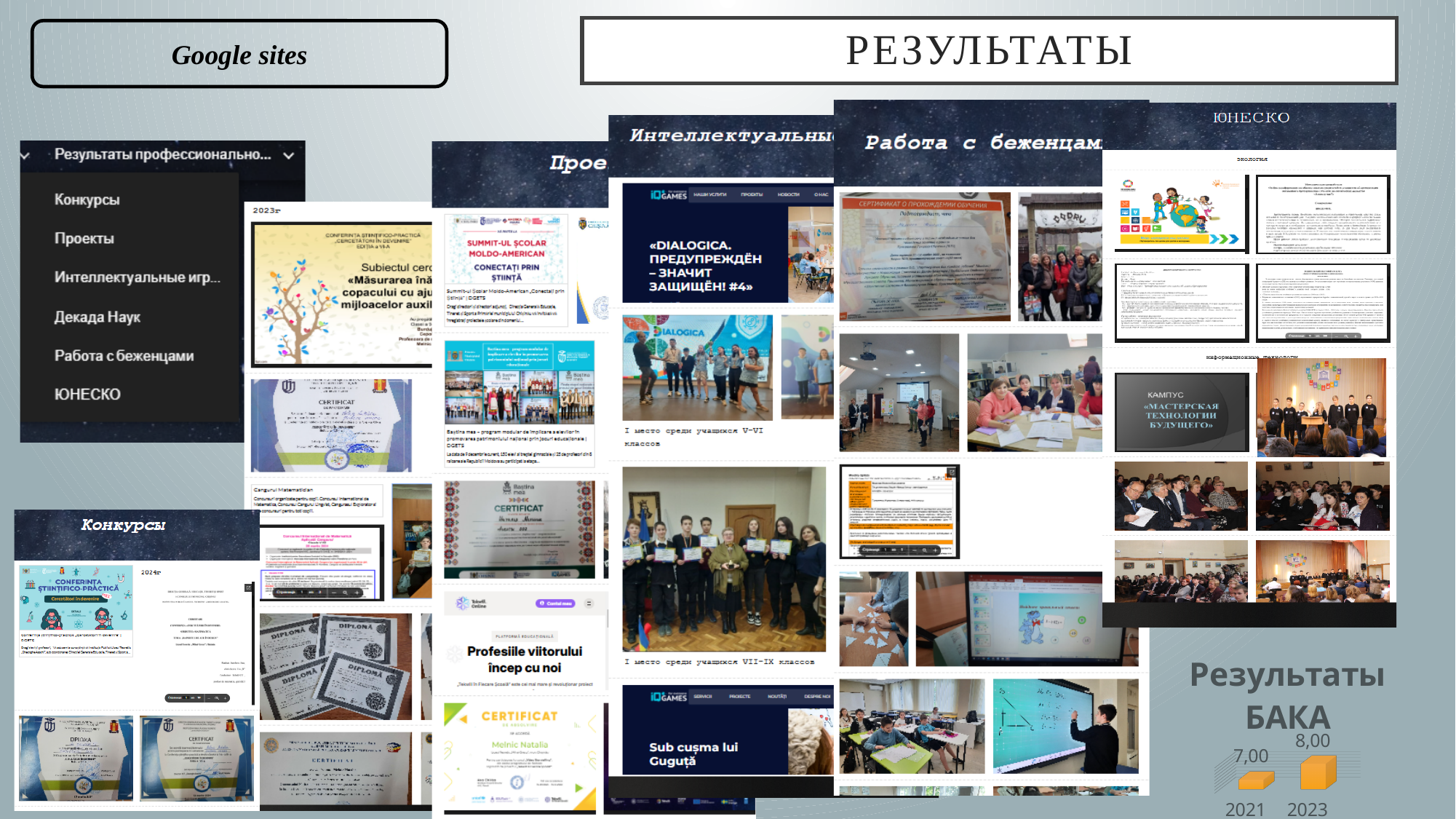
What kind of chart is the 'Результаты БАКА' chart? Bar chart In the 'Результаты БАКА' chart, what is the difference between the values for 2023 and 2021? 1,00 In the 'Результаты БАКА' chart, what is the value for 2023? 8,00 How many categories are shown in the 'Результаты БАКА' chart? 2 What colour are the bars in the 'Результаты БАКА' chart? Orange In the 'Результаты БАКА' chart, which is larger: the value for 2021 or the value for 2023? 2023 In the 'Результаты БАКА' chart, which year has the highest value? 2023 In the 'Результаты БАКА' chart, which year has the lowest value? 2021 What is the title of the chart at the bottom right of the slide? Результаты БАКА In the 'Результаты БАКА' chart, what is the value for 2021? 7,00 In the 'Результаты БАКА' chart, do the values rise or fall from 2021 to 2023? Rise